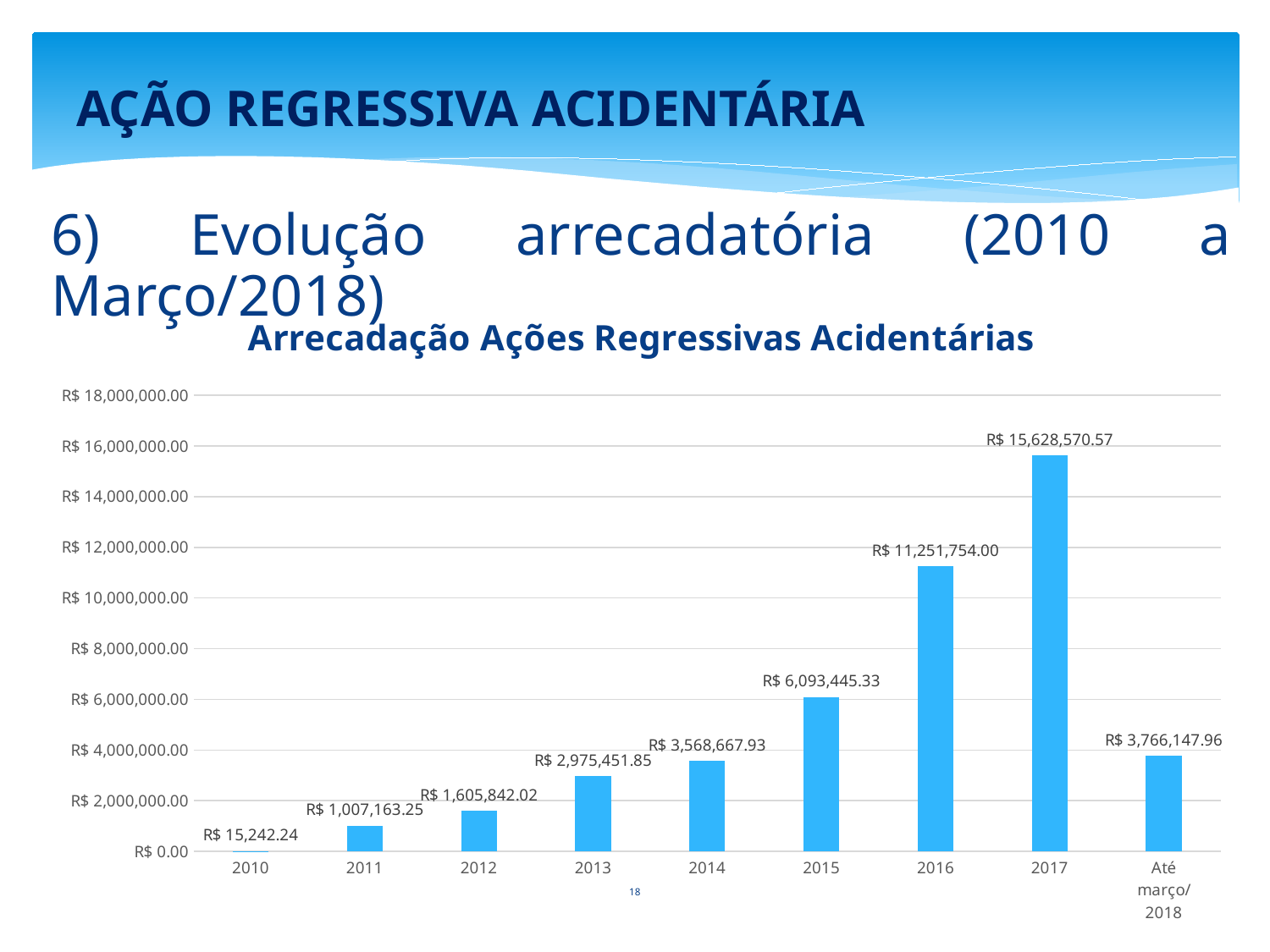
What is the value for 'Até março/2018' in the chart? R$ 3,766,147.96 What kind of chart is shown on the slide? bar chart What is the difference between the values for 2017 and 2016? R$ 4,376,816.57 What is the difference between the values for 2015 and 2014? R$ 2,524,777.40 Which is larger, the value for 2014 or the value for 'Até março/2018'? Até março/2018 Do the values rise or fall from 2010 to 2017? rise How many categories are shown on the x axis of the chart? 9 Which category has the lowest value in the chart? 2010 What is the value for 2013 in the chart? R$ 2,975,451.85 Is the value for 2015 greater or less than R$ 8,000,000.00? less Which year has the highest value in the chart? 2017 What is the value for 2016 in the chart? R$ 11,251,754.00